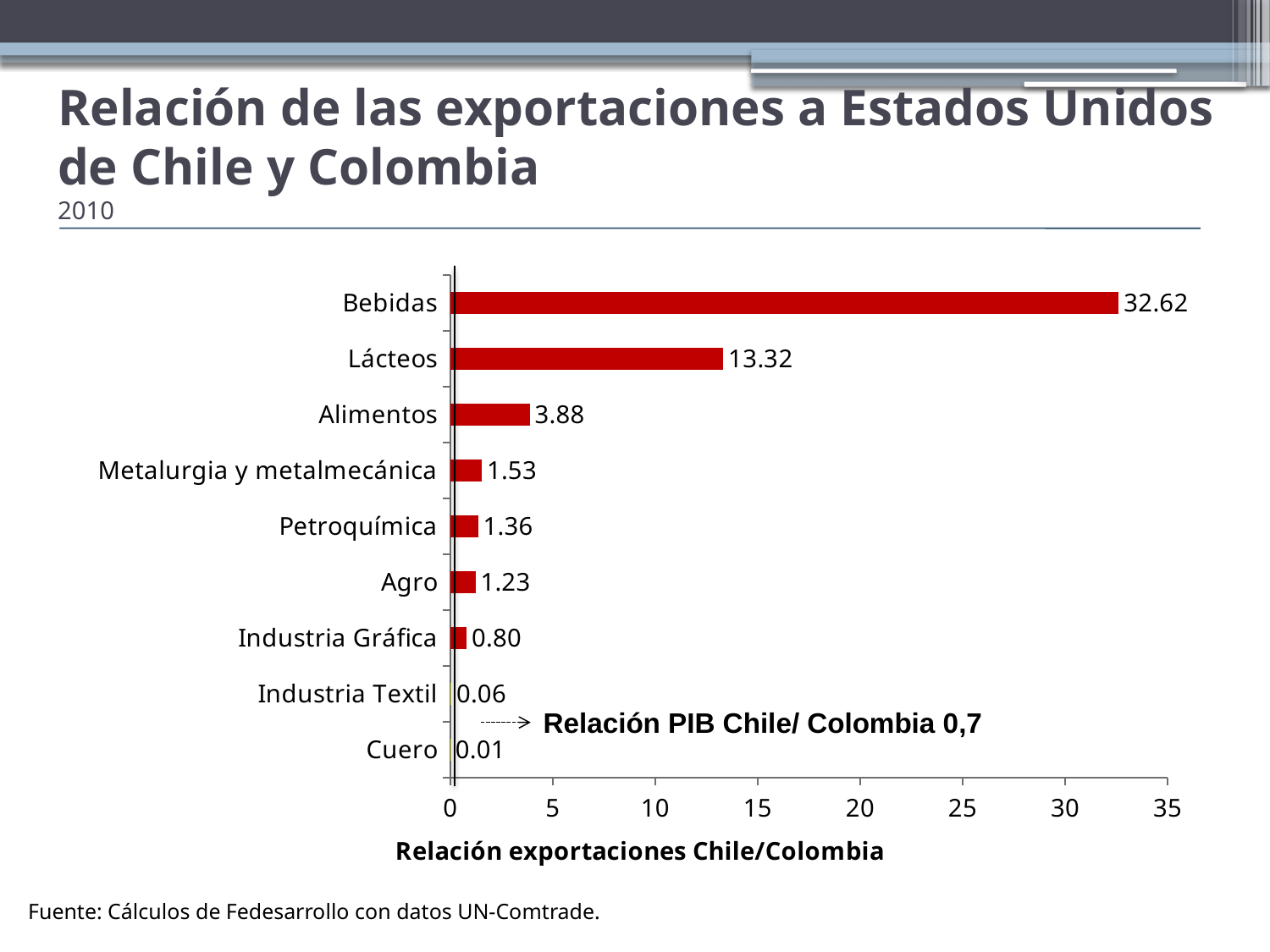
Which category has the lowest value? Cuero Is the value for Alimentos greater or less than 5? less What is the value for Metalurgia y metalmecánica? 1.53 How many categories are shown in the chart? 9 What kind of chart is shown on the slide? bar chart What is the value for Cuero? 0.01 Which category has the highest value? Bebidas What is the title of the horizontal axis? Relación exportaciones Chile/Colombia What is the value for Lácteos? 13.32 What is the value for Bebidas? 32.62 Which is larger, the value for Petroquímica or the value for Agro? Petroquímica What is the difference between the values for Bebidas and Lácteos? 19.30